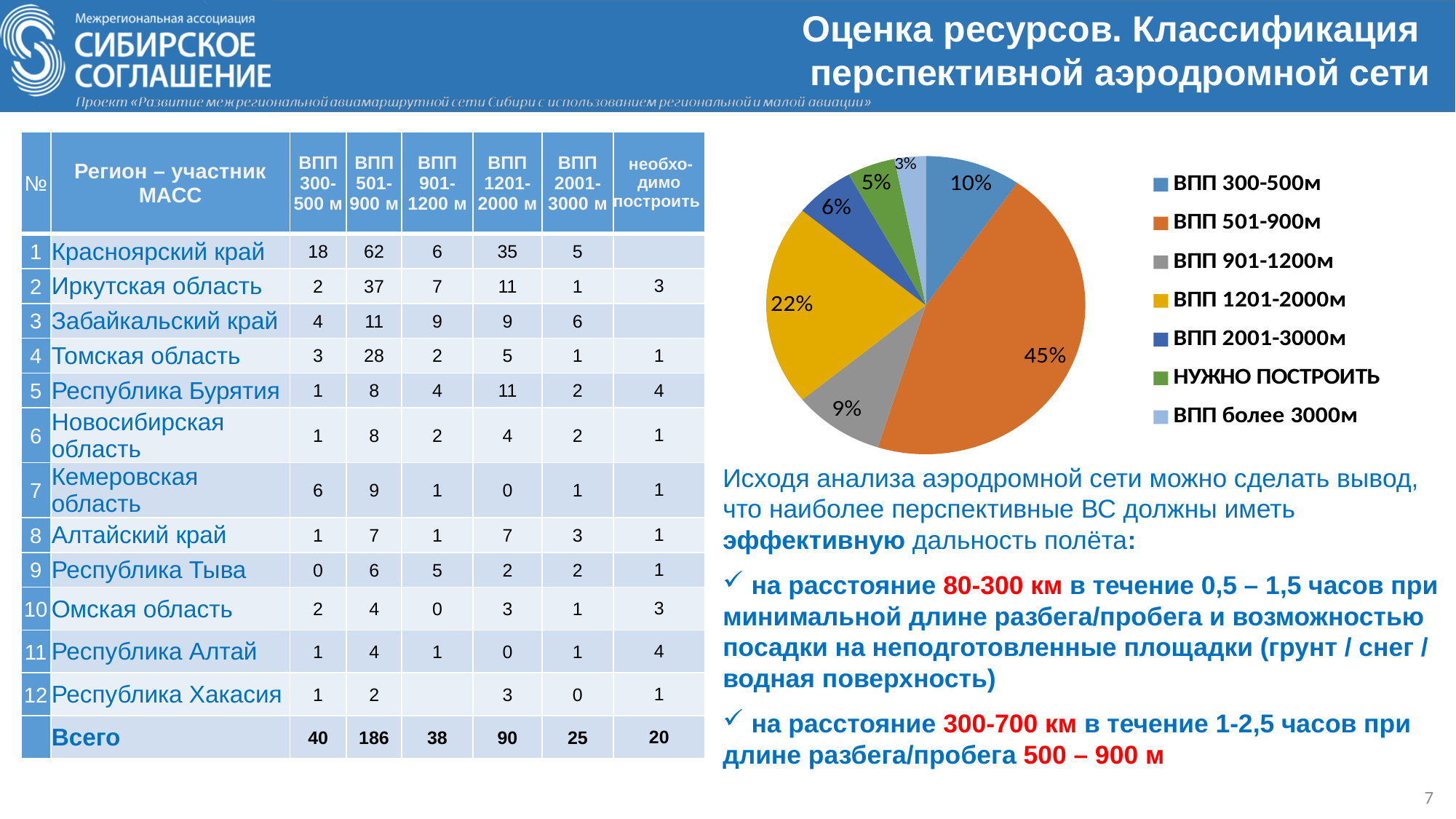
Which category has the largest slice in the pie chart? ВПП 501-900м What share of the pie chart does ВПП 300-500м have? 10% Which category has the smallest slice in the pie chart? ВПП более 3000м What is the difference in percentage points between the ВПП 501-900м slice and the ВПП 1201-2000м slice? 23 What share of the pie chart does ВПП 1201-2000м have? 22% What share of the pie chart does ВПП 901-1200м have? 9% What kind of chart is shown on the slide? pie chart How many entries does the legend of the pie chart list? 7 Which slice is larger in the pie chart: ВПП 2001-3000м or ВПП 300-500м? ВПП 300-500м How many slices does the pie chart have? 7